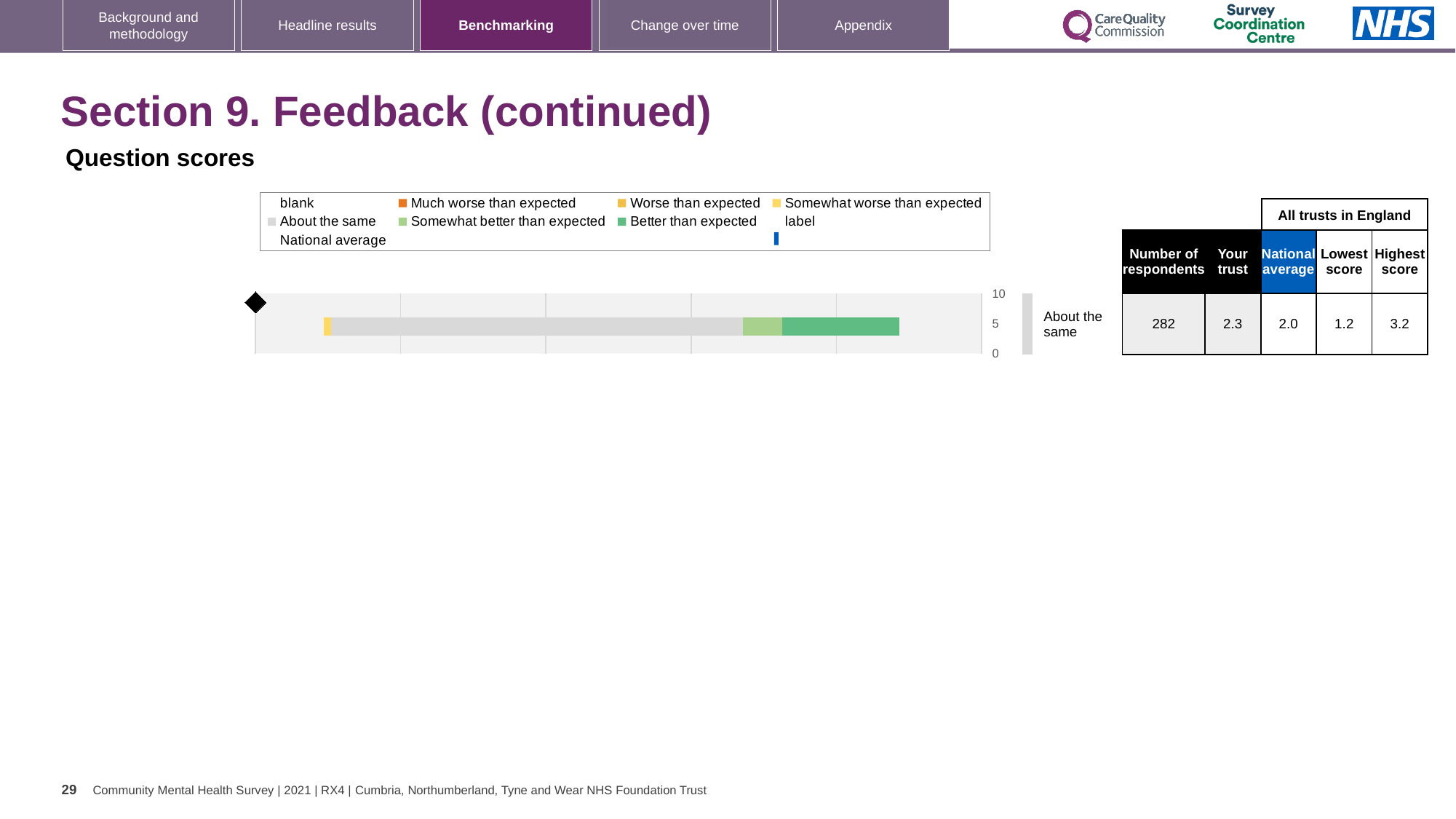
What is the national average score for the 'About the same' row? 2.0 What kind of chart is shown on the slide? bar chart What is the lowest score among all trusts in England for the 'About the same' row? 1.2 How many question rows (categories) are plotted in the chart? 1 By how much does the 'Your trust' score exceed the national average for the 'About the same' row? 0.3 What is the highest value shown on the chart's axis? 10 What is the 'Your trust' score for the 'About the same' row? 2.3 What is the difference between the highest score and the lowest score for the 'About the same' row? 2.0 What is the highest score among all trusts in England for the 'About the same' row? 3.2 What is the number of respondents shown for the 'About the same' row? 282 What colour does the legend use for 'Better than expected'? green Which is larger for the 'About the same' row: the 'Your trust' score or the national average? Your trust